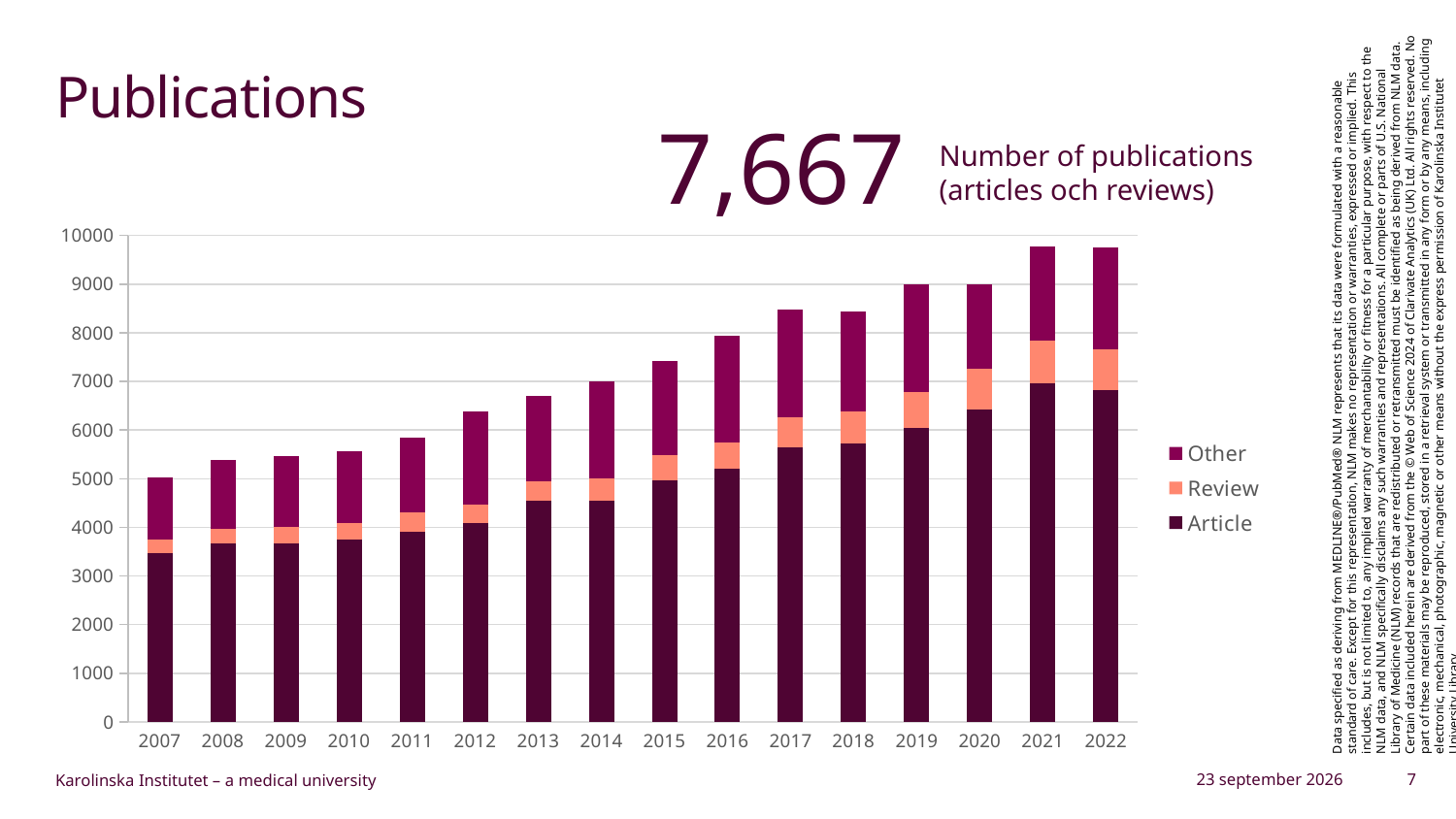
Which year has the larger total number of publications, 2007 or 2022? 2022 Is the total for 2022 greater or less than 9000? greater Do the total publications generally rise or fall from 2007 to 2022? Rise Is the Article value for 2007 greater or less than 4000? less Is the total for 2007 greater or less than 6000? less Which year has the lowest total number of publications? 2007 How many years are shown on the x axis? 16 What kind of chart is shown on the slide? Stacked bar chart Which series are listed in the legend? Other, Review, Article How many series does the legend list? 3